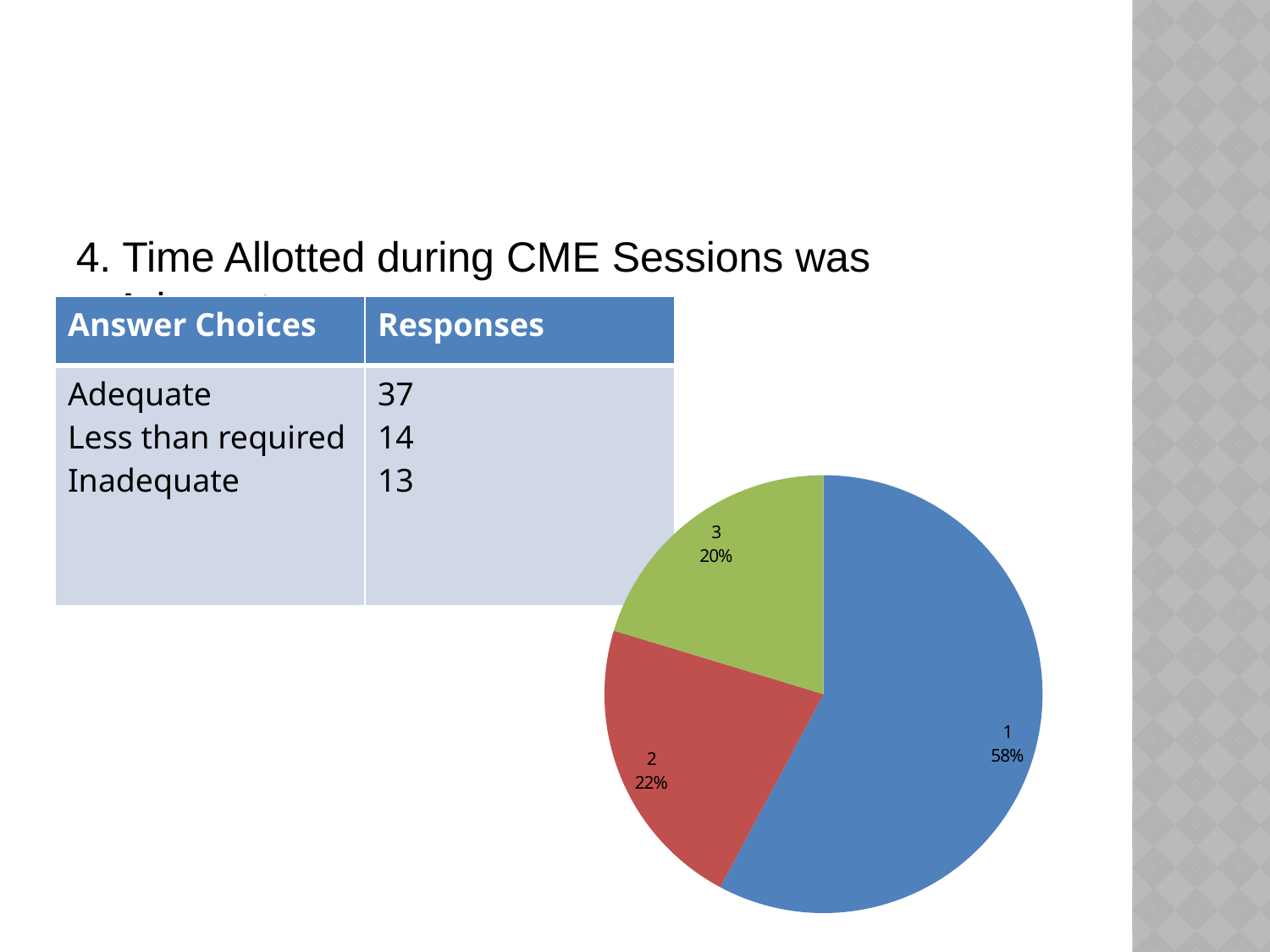
What kind of chart is shown on the slide? pie chart What colour is slice 1 in the pie chart? blue By how many percentage points does slice 1's share exceed slice 2's share? 36 What share of the pie does slice 2 represent? 22% What share of the pie does slice 3 represent? 20% What share of the pie does slice 1 represent? 58% Which slice has a larger share, slice 2 or slice 3? 2 What colour is slice 3 in the pie chart? green Which slice of the pie chart is the smallest? 3 By how many percentage points does slice 2's share exceed slice 3's share? 2 How many slices does the pie chart have? 3 Which slice of the pie chart is the largest? 1